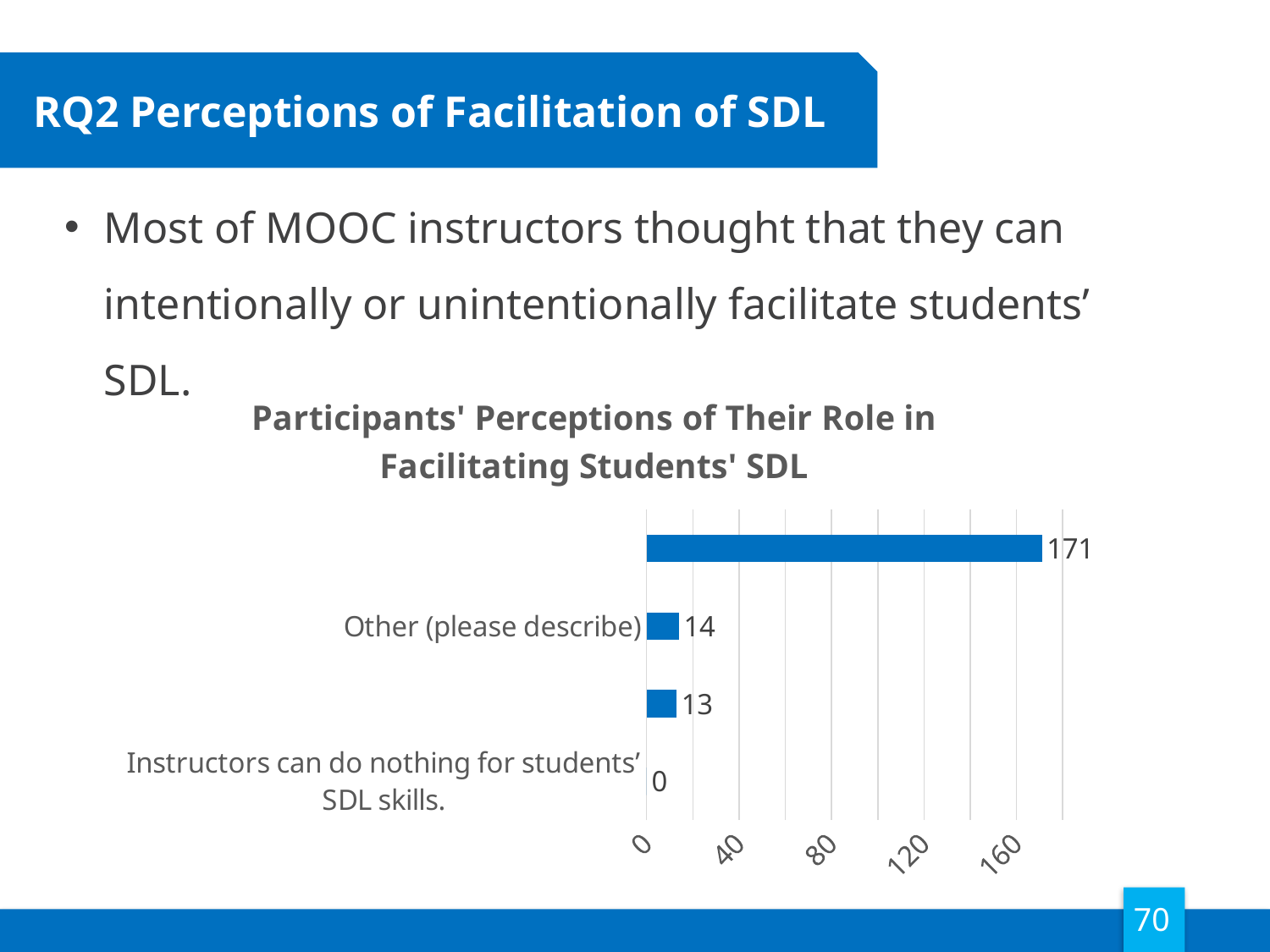
What kind of chart is shown on the slide? Bar chart What is the largest value shown on the chart? 171 What is the difference between the value for "Other (please describe)" and the value of the bar directly below it? 1 Is the value of the longest bar greater or less than 160? greater Which category has the lowest value? Instructors can do nothing for students' SDL skills. What is the title of the chart? Participants' Perceptions of Their Role in Facilitating Students' SDL What is the value for "Instructors can do nothing for students' SDL skills."? 0 What is the value for "Other (please describe)"? 14 Which is larger: the value for "Other (please describe)" or the value for "Instructors can do nothing for students' SDL skills."? Other (please describe) What is the total of all the values plotted on the chart? 198 What is the difference between the largest value on the chart and the value for "Other (please describe)"? 157 How many bars are plotted on the chart? 4